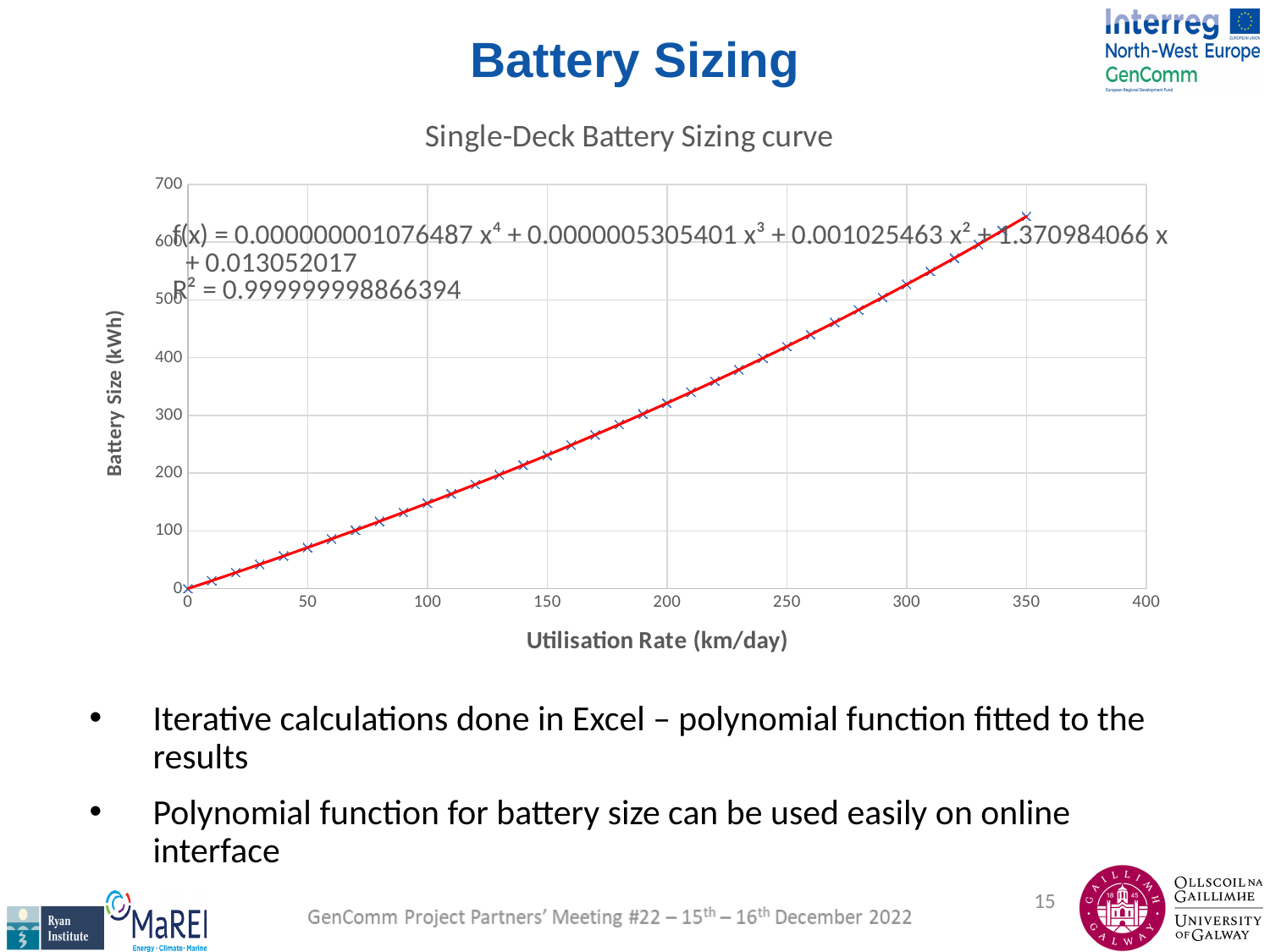
Which is larger, the battery size at 150 km/day or at 300 km/day? 300 km/day At which utilisation rate is the battery size highest? 350 km/day What is the label of the x axis? Utilisation Rate (km/day) Is the battery size at a utilisation rate of 100 km/day greater or less than 100 kWh? greater What kind of chart is shown on the slide? scatter chart Is the battery size at a utilisation rate of 100 km/day greater or less than 200 kWh? less Does the battery size rise or fall as the utilisation rate increases? rises What is the title of the chart? Single-Deck Battery Sizing curve Is the battery size at a utilisation rate of 300 km/day greater or less than 400 kWh? greater At which utilisation rate is the battery size lowest? 0 km/day